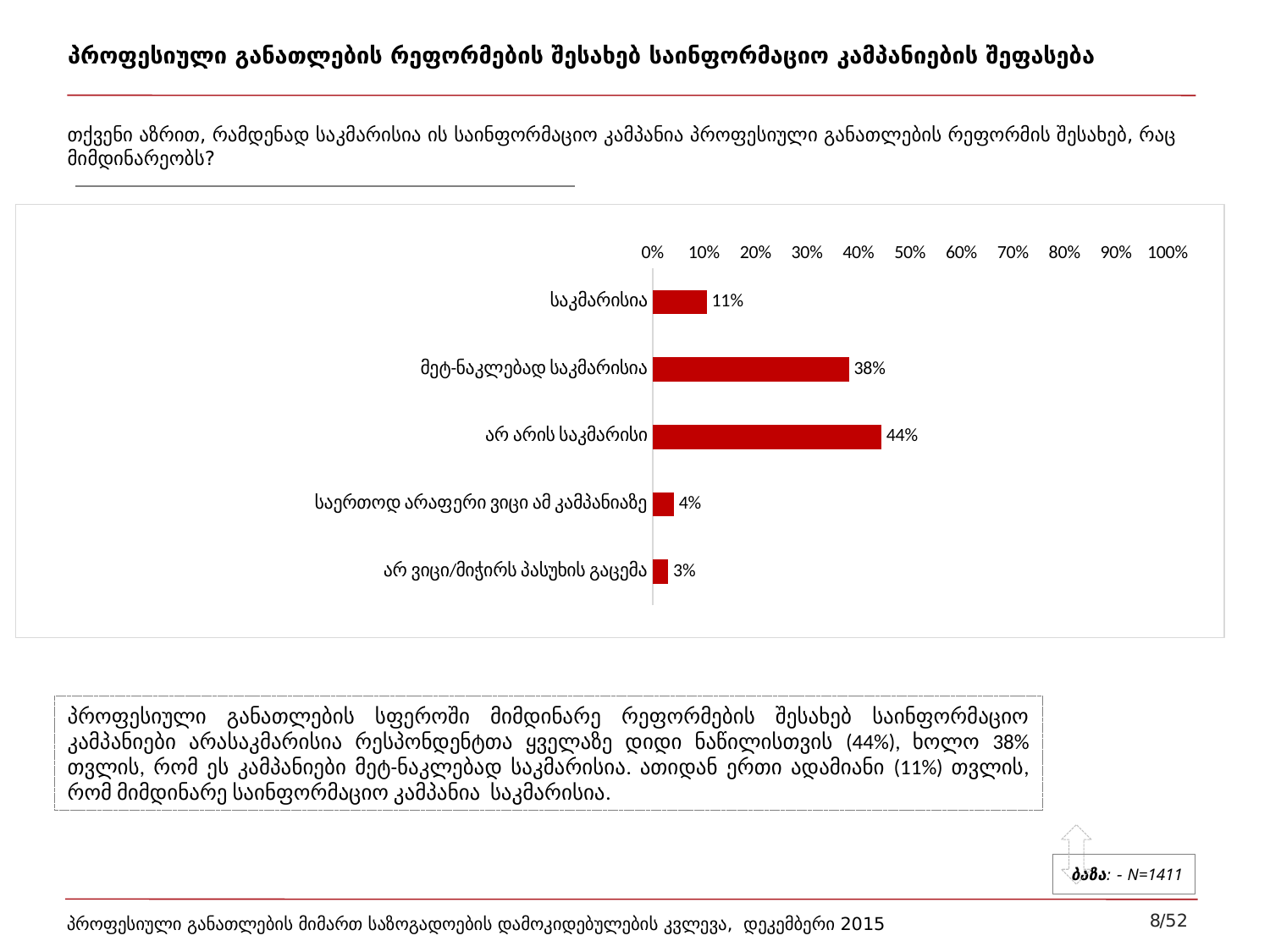
How many categories are shown in the chart? 5 Which is larger, the value for "საკმარისია" or the value for "მეტ-ნაკლებად საკმარისია"? მეტ-ნაკლებად საკმარისია What is the value for "არ ვიცი/მიჭირს პასუხის გაცემა"? 3% What kind of chart is shown on the slide? bar chart Which category has the lowest value? არ ვიცი/მიჭირს პასუხის გაცემა What is the value for "საკმარისია"? 11% What is the difference between the values for "არ არის საკმარისი" and "მეტ-ნაკლებად საკმარისია"? 6% Is the value for "არ არის საკმარისი" greater or less than 50%? less What is the value for "საერთოდ არაფერი ვიცი ამ კამპანიაზე"? 4% What is the value for "მეტ-ნაკლებად საკმარისია"? 38% Which category has the highest value? არ არის საკმარისი What is the value for "არ არის საკმარისი"? 44%